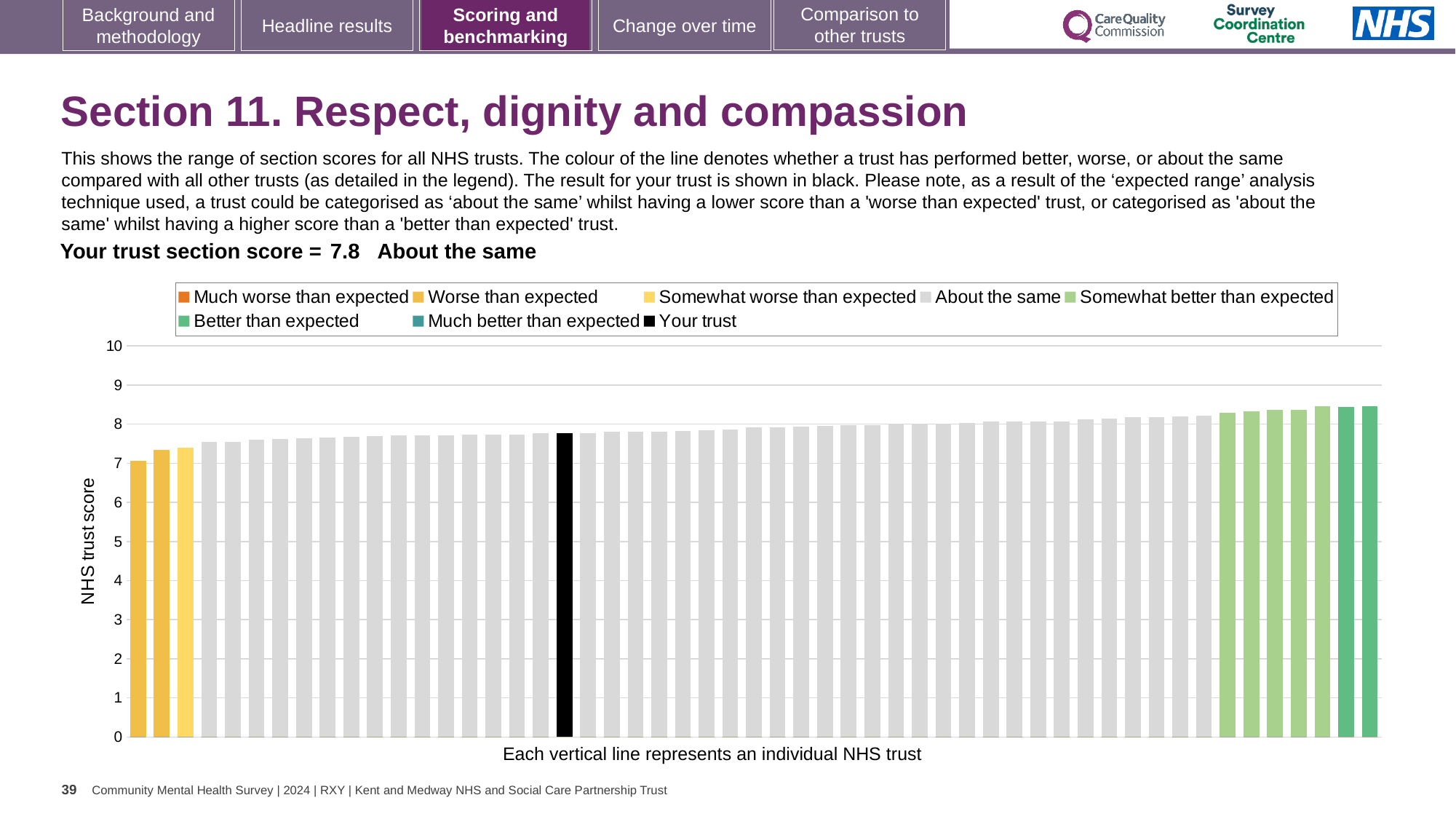
What is the section score for your trust shown on the slide? 7.8 What is the label on the vertical axis of the chart? NHS trust score Which category is your trust placed in for this section? About the same What colour is the bar representing your trust? black How many bars are coloured as 'Worse than expected'? 2 What kind of chart is shown on the slide? bar chart How many entries does the chart legend list? 8 Is the value for your trust greater or less than 7? greater Is the highest trust score on the chart greater or less than 8? greater Is the lowest trust score on the chart greater or less than 8? less Do the trust scores rise or fall moving from left to right along the x axis? rise